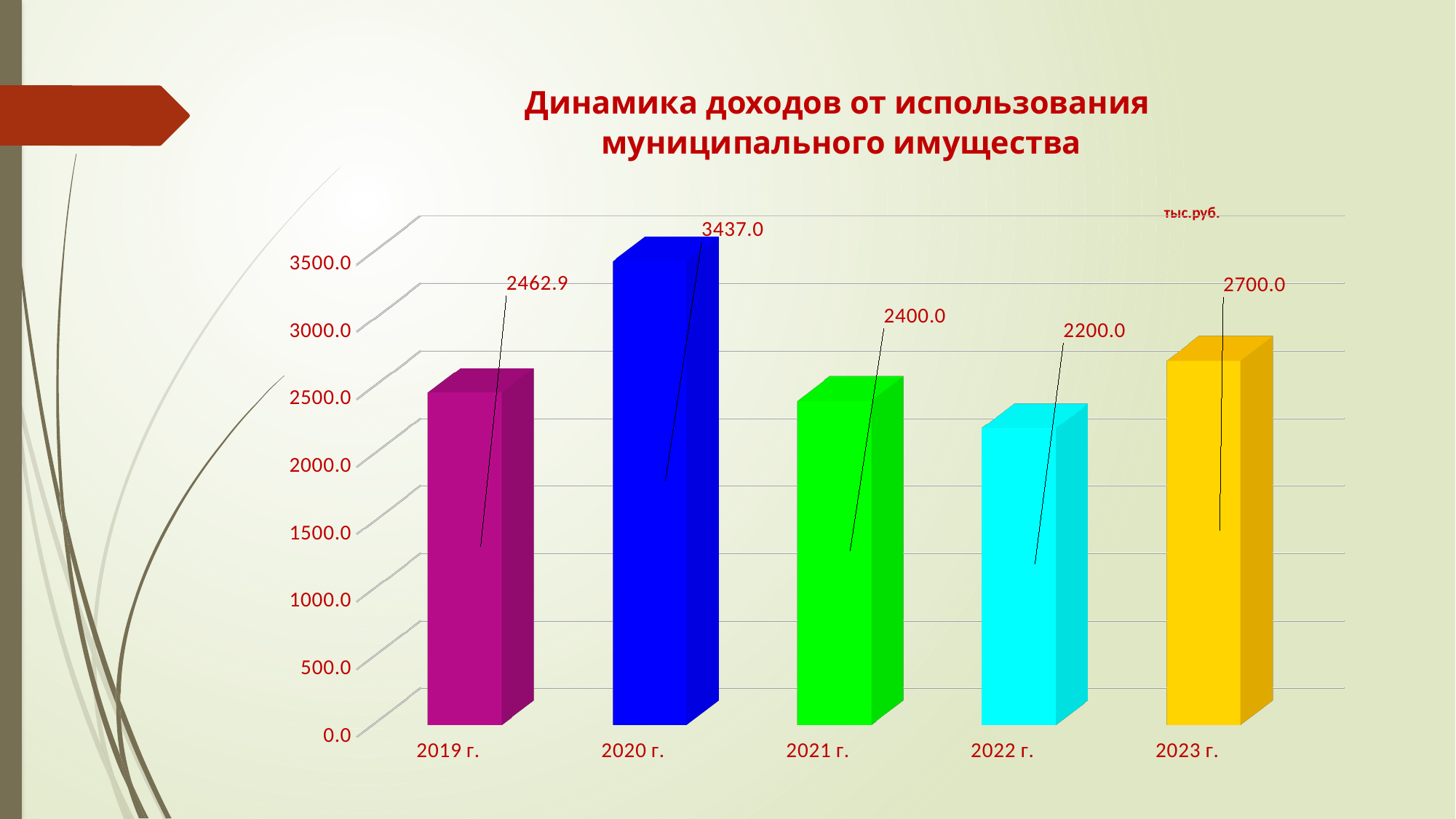
What unit is indicated on the chart? тыс.руб. How many years are shown on the chart? 5 Which year has the lowest value? 2022 г. What is the value for 2020 г.? 3437.0 What is the value for 2023 г.? 2700.0 What is the difference between the values for 2020 г. and 2021 г.? 1037.0 What is the value for 2022 г.? 2200.0 What is the difference between the values for 2023 г. and 2022 г.? 500.0 What is the value for 2019 г.? 2462.9 What kind of chart is shown on the slide? Bar chart Which year has the highest value? 2020 г. Which is larger, the value for 2019 г. or the value for 2021 г.? 2019 г.